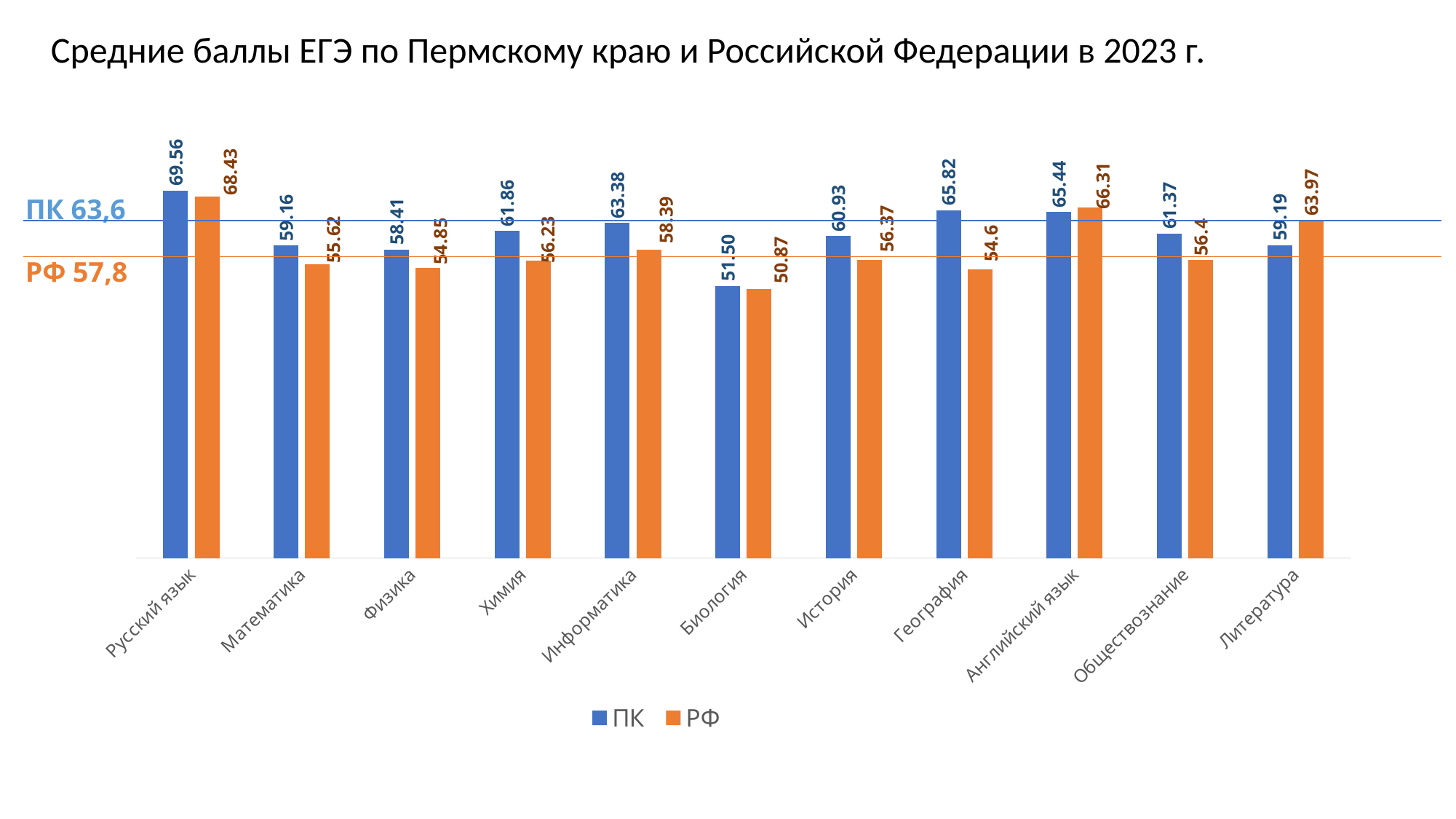
Which subject has the highest ПК value? Русский язык For Английский язык, which is larger: the ПК value or the РФ value? РФ How many series does the legend list? 2 What is the ПК value for География? 65.82 What is the ПК value for Информатика? 63.38 What is the title of the chart? Средние баллы ЕГЭ по Пермскому краю и Российской Федерации в 2023 г. What kind of chart is shown on the slide? Bar chart What is the difference between the ПК and РФ values for География? 11.22 What is the РФ value for Литература? 63.97 How many subjects are shown on the x axis? 11 For Химия, which is larger: the ПК value or the РФ value? ПК Which subject has the lowest РФ value? Биология